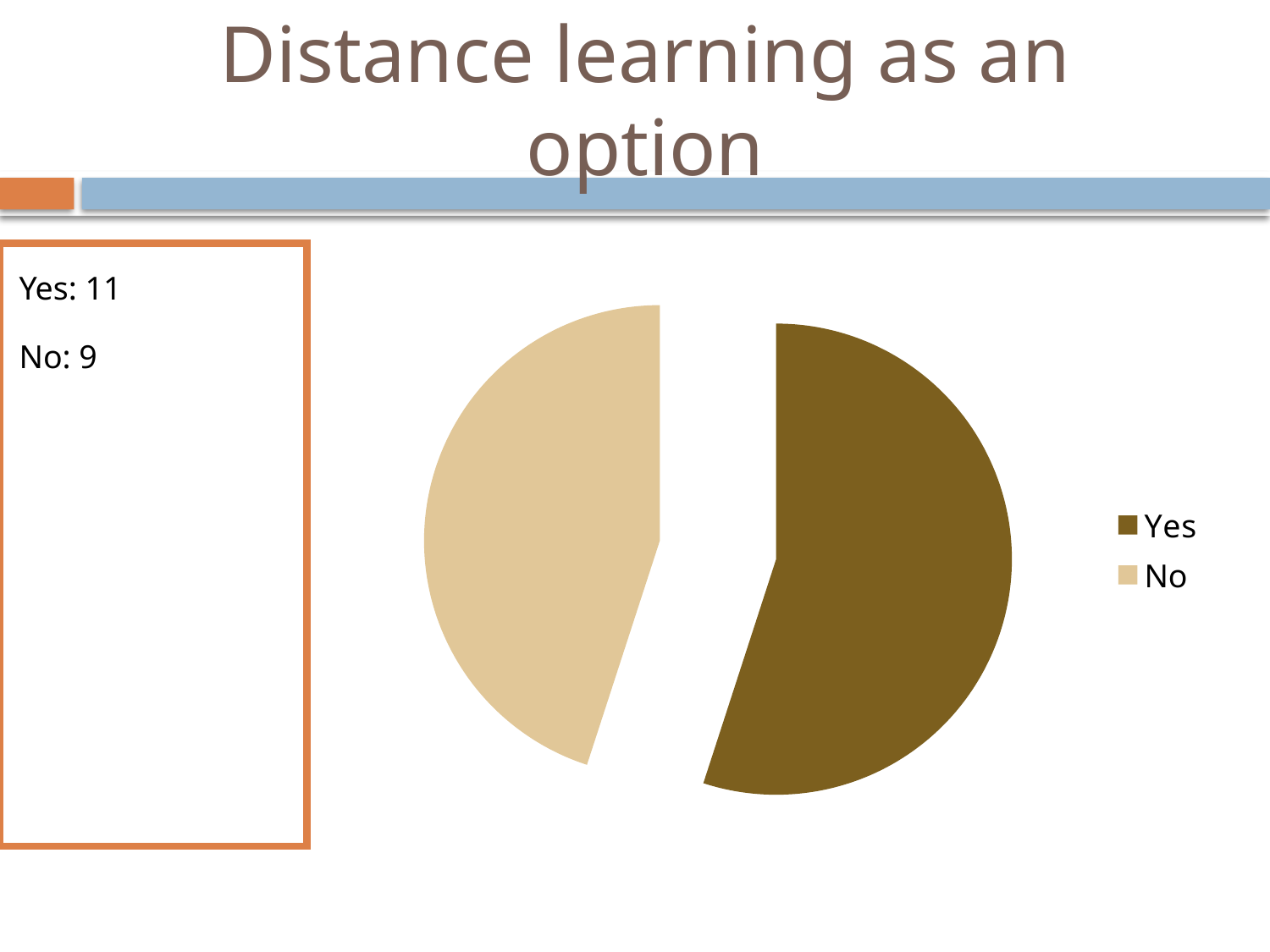
How many slices does the pie chart have? 2 What is the total of the Yes and No values? 20 How many entries does the legend list? 2 What is the value for No? 9 Which category has the smaller slice of the pie? No Which category has the larger slice of the pie? Yes What is the title of the slide containing the pie chart? Distance learning as an option What is the value for Yes? 11 What is the difference between the Yes and No values? 2 Is the slice for Yes larger or smaller than the slice for No? larger What share of the pie does the Yes slice represent? 55% What kind of chart is shown on the slide? pie chart